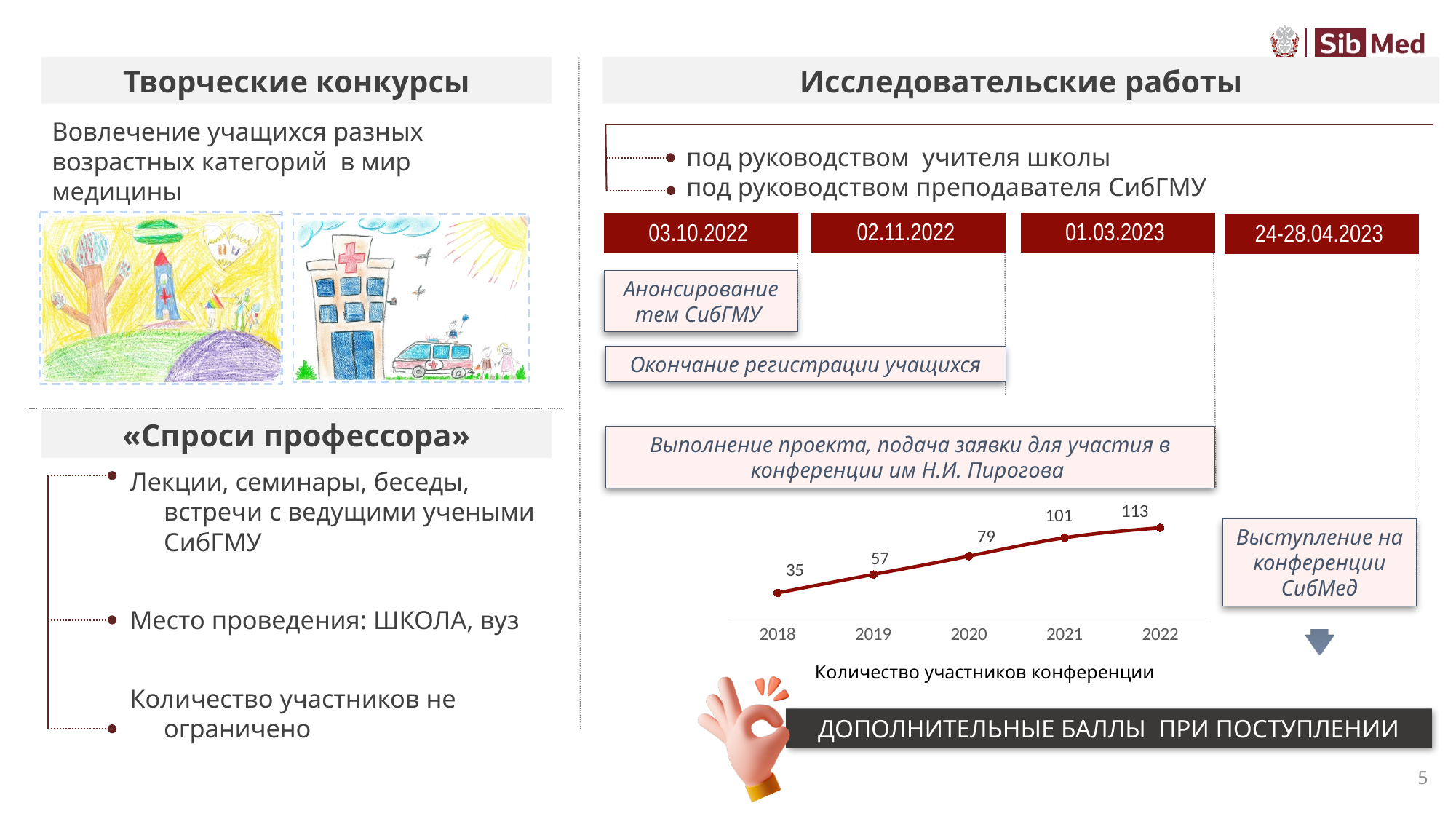
How many years are plotted on the chart? 5 Which year had more conference participants, 2019 or 2020? 2020 What is the number of conference participants in 2020? 79 What is the number of conference participants in 2022? 113 Does the number of conference participants rise or fall from 2018 to 2022? rise What is the difference in conference participants between 2021 and 2019? 44 By how much did the number of conference participants increase from 2018 to 2022? 78 What kind of chart shows the number of conference participants? line chart Which year has the lowest number of conference participants? 2018 What is the number of conference participants in 2018? 35 Which year has the highest number of conference participants? 2022 What is the caption of the chart? Количество участников конференции